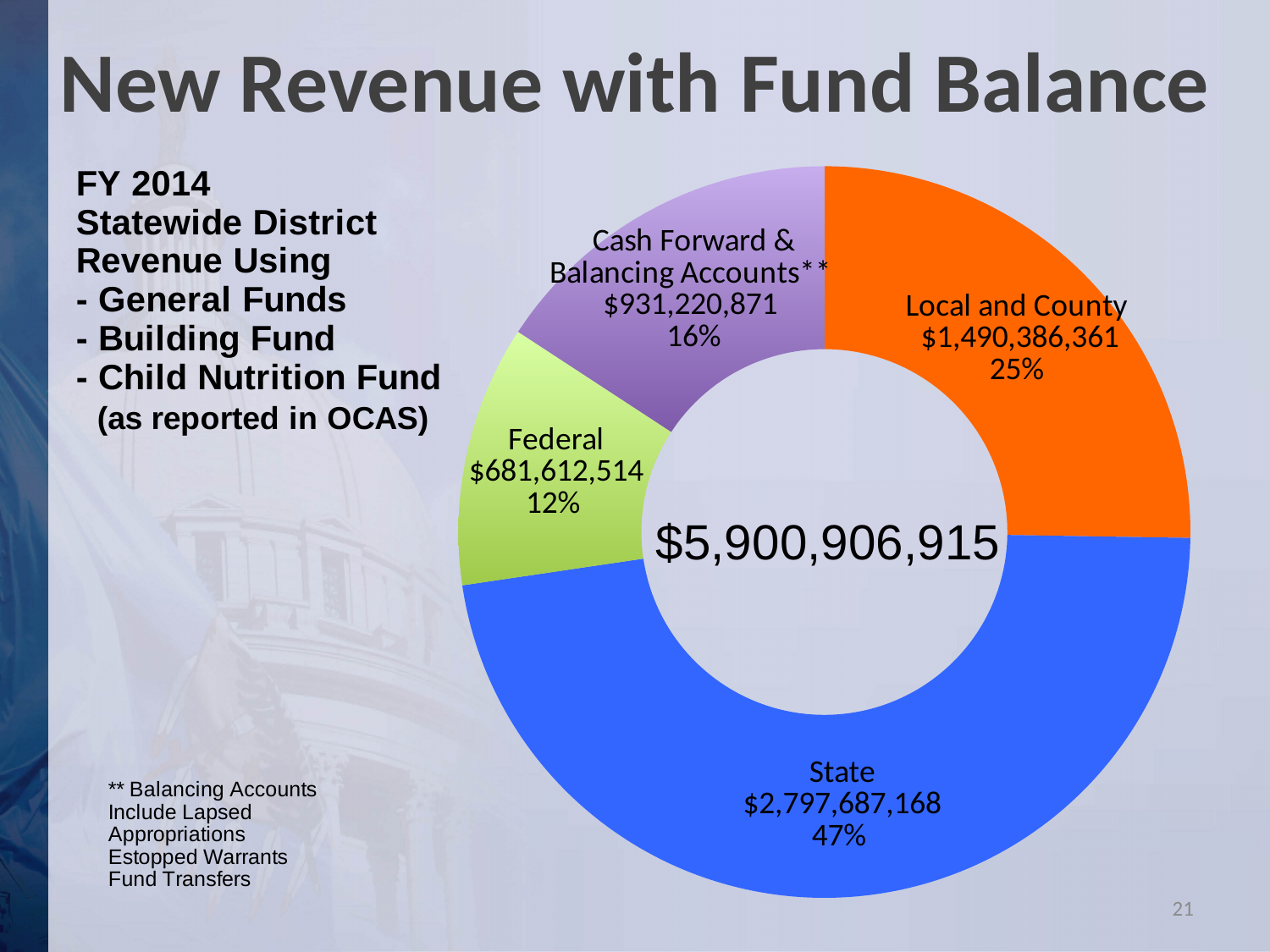
Which revenue source has the smallest share? Federal What is the difference in dollars between State and Local and County revenue? $1,307,300,807 What total amount is shown in the center of the chart? $5,900,906,915 What percentage share does Local and County have? 25% Which revenue source has the largest share? State What is the revenue amount for Federal? $681,612,514 What percentage share does Cash Forward & Balancing Accounts have? 16% How many percentage points larger is the State share than the Local and County share? 22% How many revenue categories are shown in the chart? 4 What is the revenue amount for State? $2,797,687,168 Which is larger, Federal revenue or Cash Forward & Balancing Accounts revenue? Cash Forward & Balancing Accounts What type of chart is shown on the slide? doughnut chart